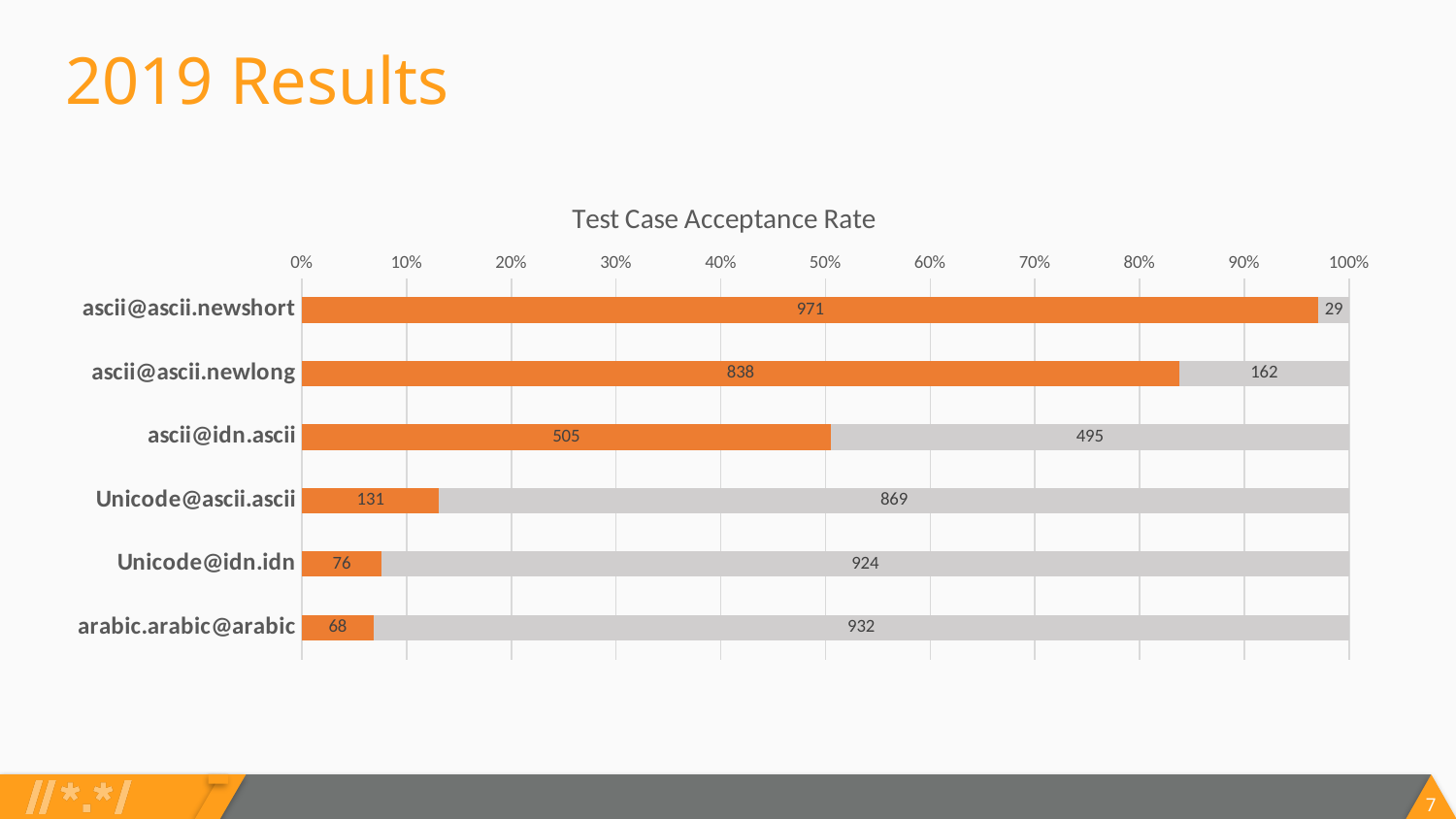
What is the value of the orange segment for ascii@ascii.newshort? 971 Is the orange segment for Unicode@ascii.ascii greater or less than 20% of the bar? less What is the difference between the orange and grey segments for ascii@idn.ascii? 10 How many categories are shown on the chart? 6 Which category has the smallest orange segment? arabic.arabic@arabic What is the value of the orange segment for Unicode@idn.idn? 76 What is the value of the grey segment for ascii@ascii.newlong? 162 Which category has the largest orange segment? ascii@ascii.newshort What is the title of the chart? Test Case Acceptance Rate What is the total of the two segments for Unicode@ascii.ascii? 1000 Which is larger, the orange segment for ascii@ascii.newlong or the orange segment for ascii@idn.ascii? ascii@ascii.newlong What type of chart is shown on the slide? bar chart